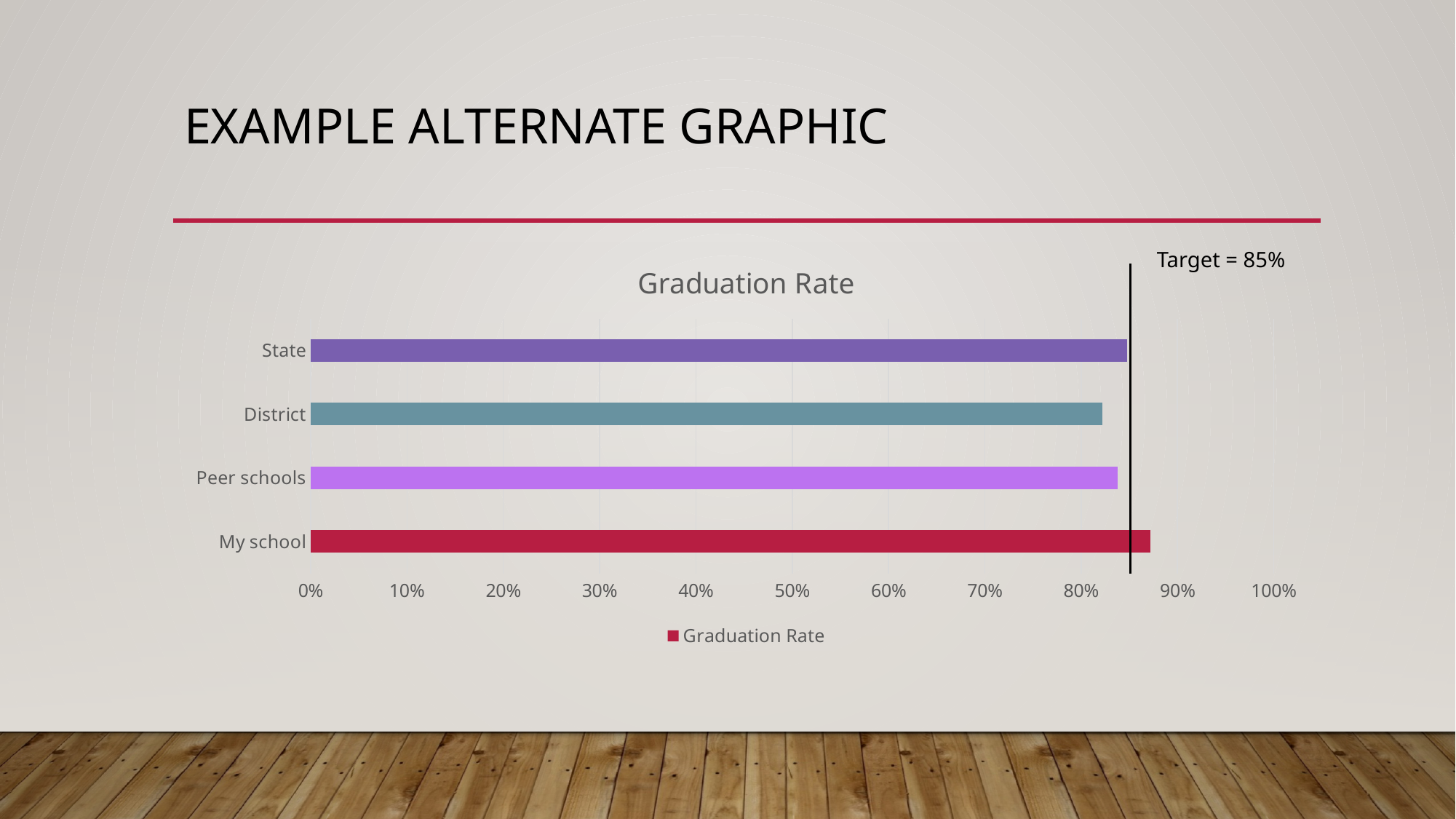
Which category has the highest graduation rate? My school What target value is marked by the vertical line on the chart? 85% Is the graduation rate for My school greater or less than 80%? greater Is the graduation rate for District greater or less than 90%? less Which has a higher graduation rate, State or District? State How many series does the legend list? 1 Is the graduation rate for State greater or less than 70%? greater What is the title of the chart? Graduation Rate Which has a higher graduation rate, My school or District? My school What kind of chart is shown on the slide? Bar chart How many categories are plotted in the Graduation Rate chart? 4